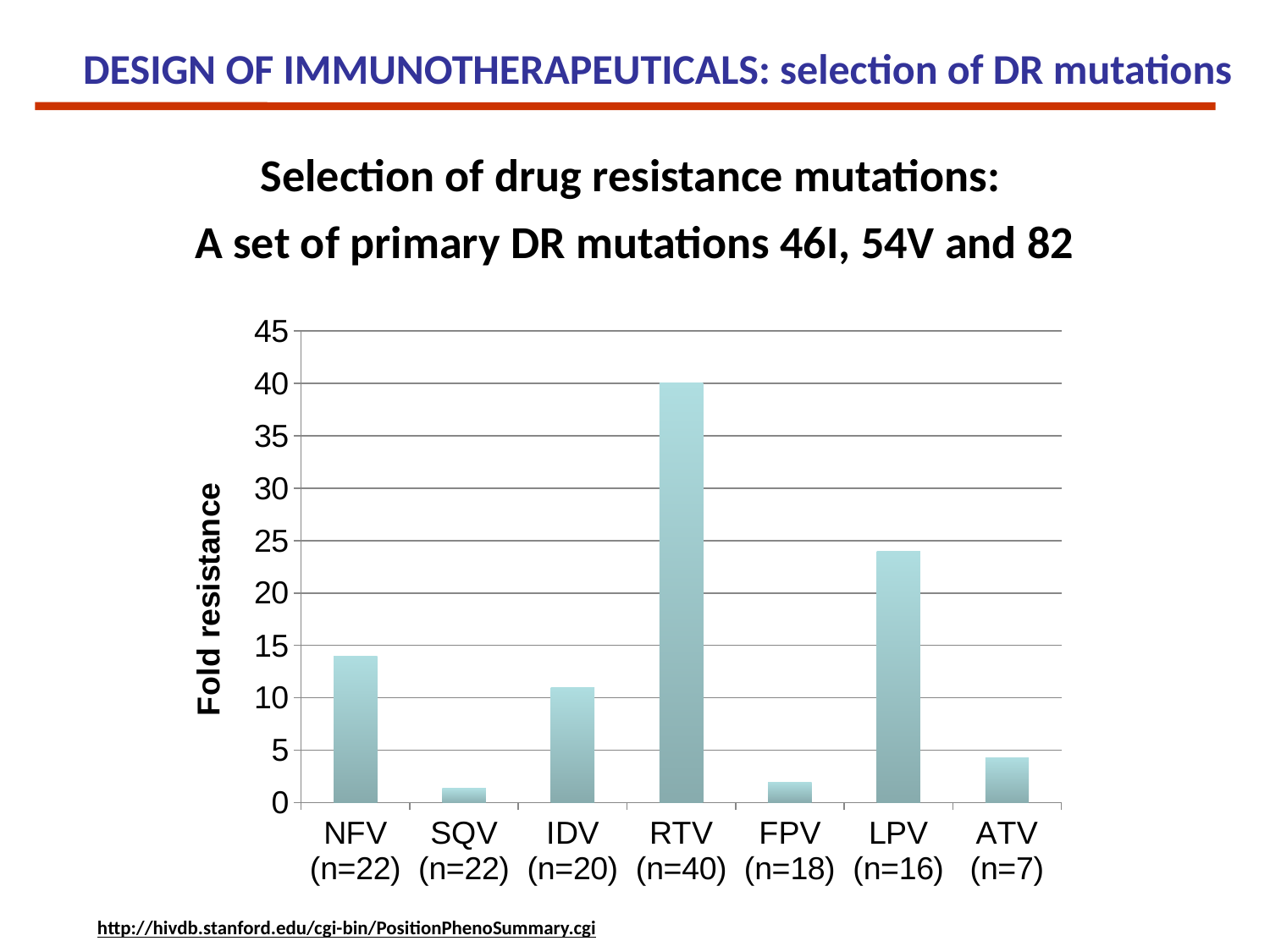
What is the fold resistance value for RTV (n=40)? 40 Is the fold resistance for FPV (n=18) greater or less than 5? less How many drug categories are shown on the x axis of the chart? 7 Which has a higher fold resistance, LPV (n=16) or NFV (n=22)? LPV (n=16) Is the fold resistance for LPV (n=16) greater or less than 20? greater Which drug has the highest fold resistance in the chart? RTV (n=40) Is the fold resistance for ATV (n=7) greater or less than 5? less Which has a higher fold resistance, NFV (n=22) or IDV (n=20)? NFV (n=22) What is the label of the y axis of the chart? Fold resistance What kind of chart is shown on the slide? bar chart